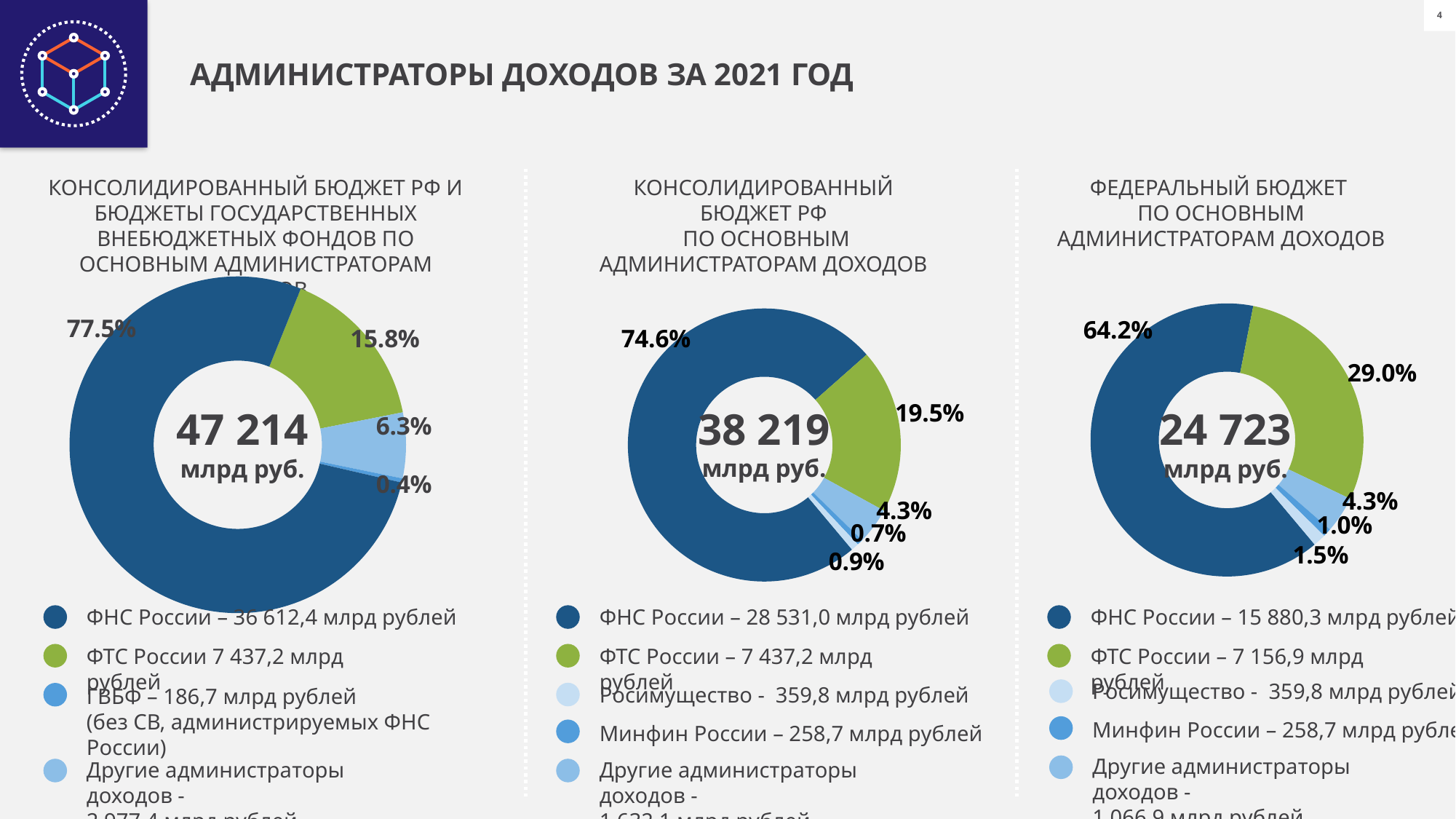
In the middle chart (Консолидированный бюджет РФ по основным администраторам доходов), what share does ФТС России account for? 19.5% In the right chart, which administrator has the smallest share? Минфин России In the right chart (Федеральный бюджет по основным администраторам доходов), what share does ФНС России account for? 64.2% What type of chart is used on this slide? Donut (pie) chart In the right chart, what is the difference in percentage points between the ФНС России share (64.2%) and the ФТС России share (29.0%)? 35.2 In the left chart (Консолидированный бюджет РФ и бюджеты государственных внебюджетных фондов), what share of the total does ФНС России account for? 77.5% How many slices does the middle chart (Консолидированный бюджет РФ по основным администраторам доходов) have? 5 In the middle chart, which is larger: the share of Росимущество or the share of Минфин России? Росимущество What total value is shown in the centre of the right chart (Федеральный бюджет по основным администраторам доходов)? 24 723 млрд руб. According to the legend of the left chart, what is the value for ФНС России? 36 612,4 млрд рублей In the left chart, which administrator has the largest share? ФНС России What total value is shown in the centre of the middle chart (Консолидированный бюджет РФ по основным администраторам доходов)? 38 219 млрд руб.